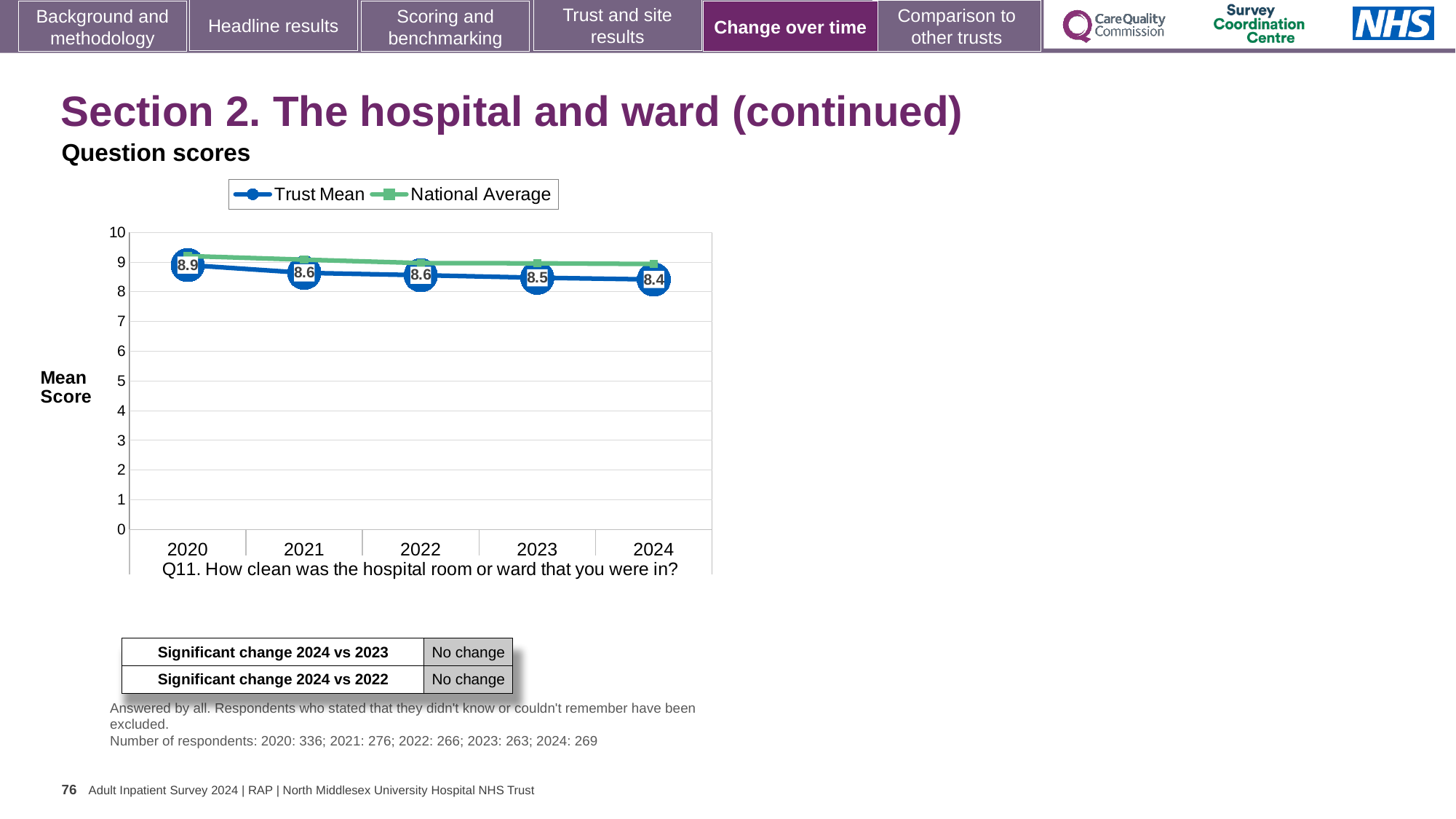
What is the Trust Mean score for 2020? 8.9 How many years are shown on the x axis? 5 In which year is the Trust Mean score highest? 2020 How many series does the legend list? 2 What is the difference between the Trust Mean score in 2020 and in 2024? 0.5 Does the Trust Mean rise or fall from 2020 to 2024? Fall Is the National Average value for 2024 greater or less than 8? greater In 2024, which is higher: the Trust Mean or the National Average? National Average What is the Trust Mean score for 2024? 8.4 In which year is the Trust Mean score lowest? 2024 What kind of chart is shown? Line chart What is the Trust Mean score for 2023? 8.5